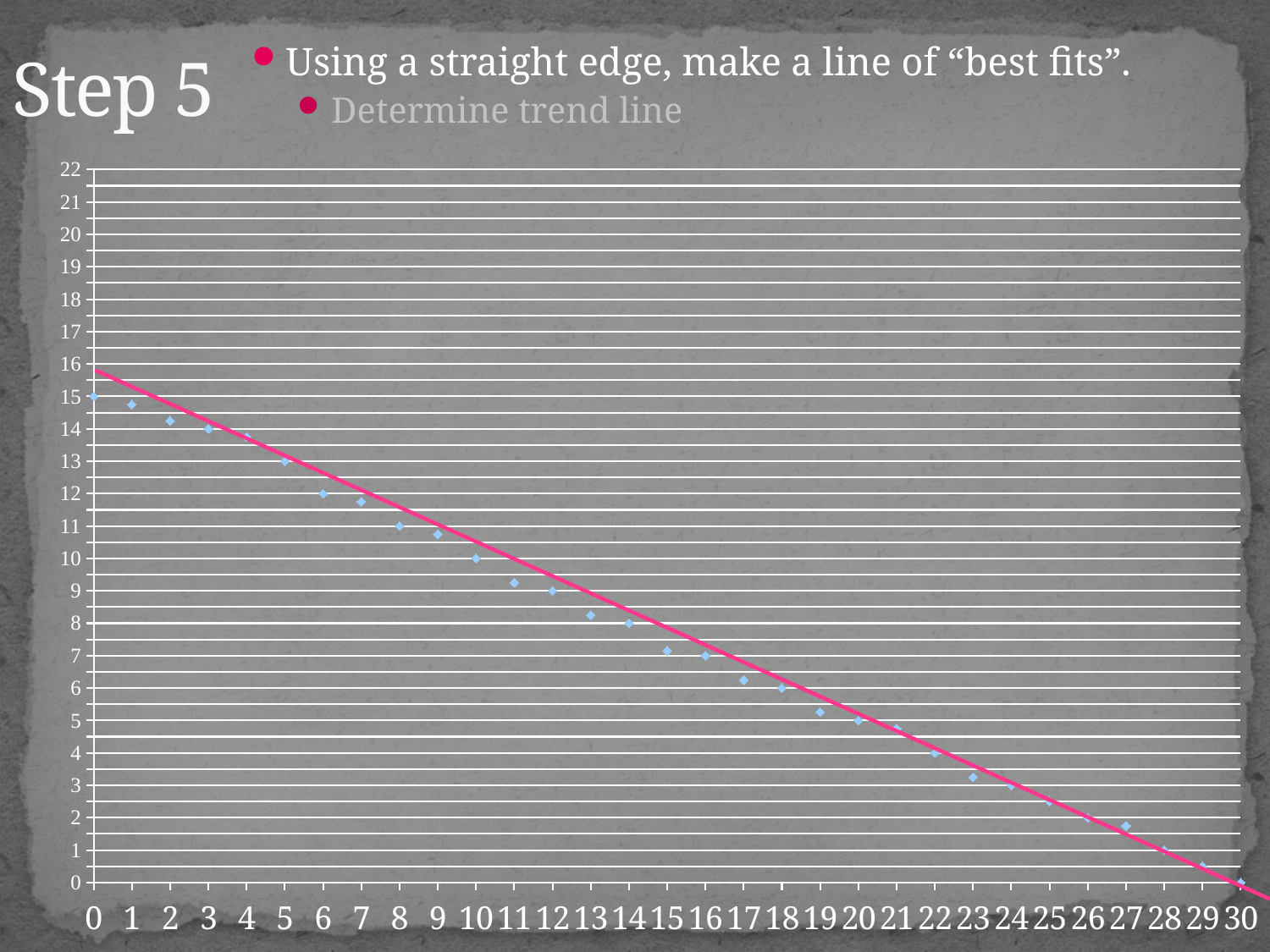
How many data points are plotted on the chart? 31 Is the plotted value at x = 7 greater or less than 12? less Is the plotted value at x = 25 greater or less than 3? less Do the plotted values rise or fall as x increases from 0 to 30? fall What kind of chart is shown on the slide? scatter chart At which x value is the plotted point highest? 0 What is the plotted value at x = 30? 0 At which x value is the plotted point lowest? 30 What is the highest value shown on the y axis? 22 What is the plotted value at x = 0? 15 Which plotted point is larger, the one at x = 5 or the one at x = 20? x = 5 Is the plotted value at x = 9 greater or less than 10? greater